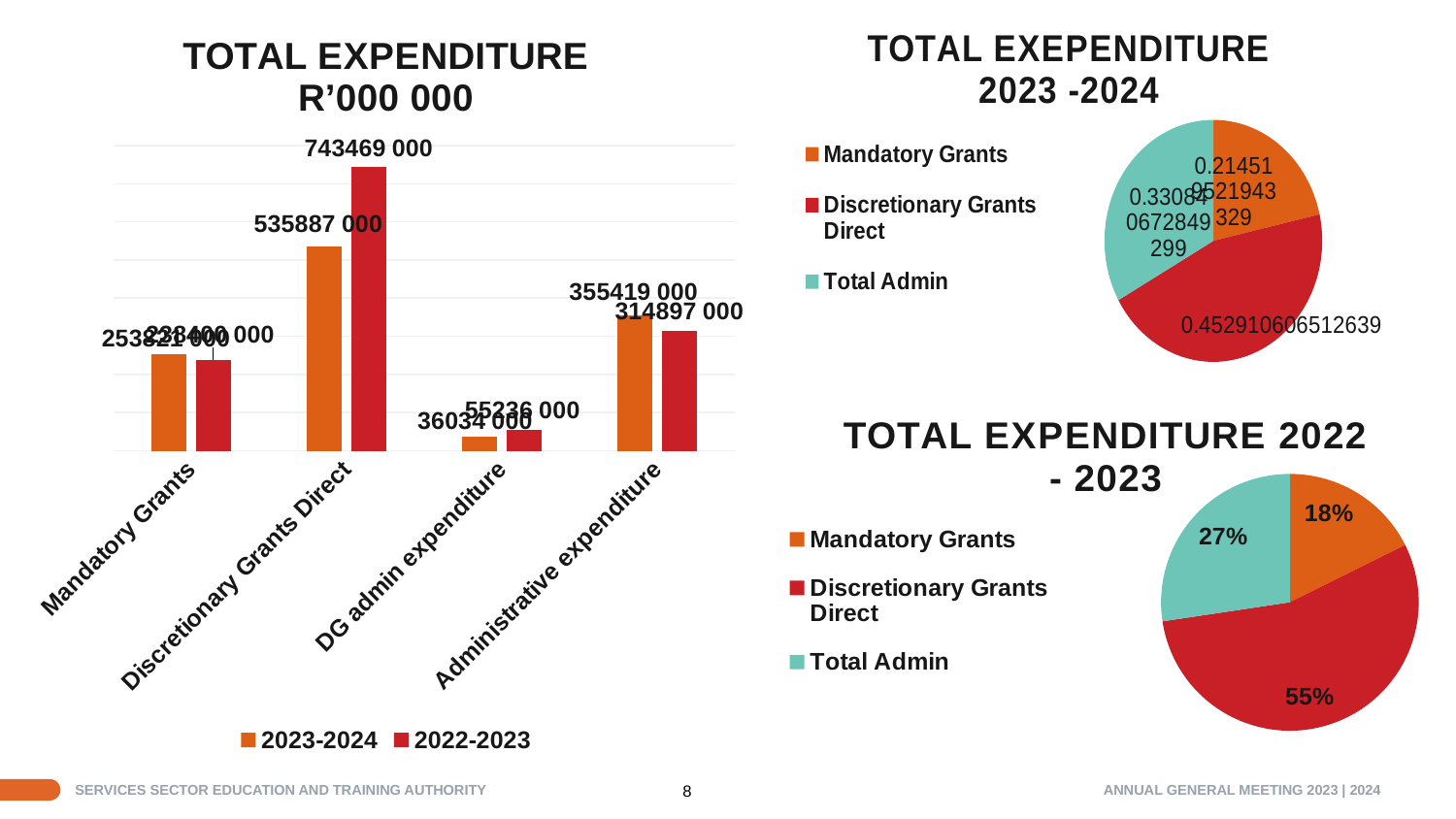
In the bar chart titled TOTAL EXPENDITURE R'000 000, what is the difference between the 2022-2023 and 2023-2024 values for Discretionary Grants Direct? 207582 000 In the pie chart titled TOTAL EXPENDITURE 2022 - 2023, what share does Discretionary Grants Direct have? 55% In the bar chart titled TOTAL EXPENDITURE R'000 000, which category has the lowest values? DG admin expenditure In the bar chart titled TOTAL EXPENDITURE R'000 000, what is the value for Administrative expenditure in 2023-2024? 355419 000 In the bar chart titled TOTAL EXPENDITURE R'000 000, what is the value for DG admin expenditure in 2023-2024? 36034 000 In the pie chart titled TOTAL EXPENDITURE 2022 - 2023, what share does Total Admin have? 27% In the bar chart titled TOTAL EXPENDITURE R'000 000, what is the value for Discretionary Grants Direct in 2022-2023? 743469 000 What kind of chart is the chart titled TOTAL EXPENDITURE R'000 000 on the left of the slide? bar chart In the bar chart titled TOTAL EXPENDITURE R'000 000, for Administrative expenditure, which year has the larger value, 2023-2024 or 2022-2023? 2023-2024 In the bar chart titled TOTAL EXPENDITURE R'000 000, which category has the tallest bar? Discretionary Grants Direct In the bar chart titled TOTAL EXPENDITURE R'000 000, how many categories are shown on the x axis? 4 In the bar chart titled TOTAL EXPENDITURE R'000 000, how many series does the legend list? 2